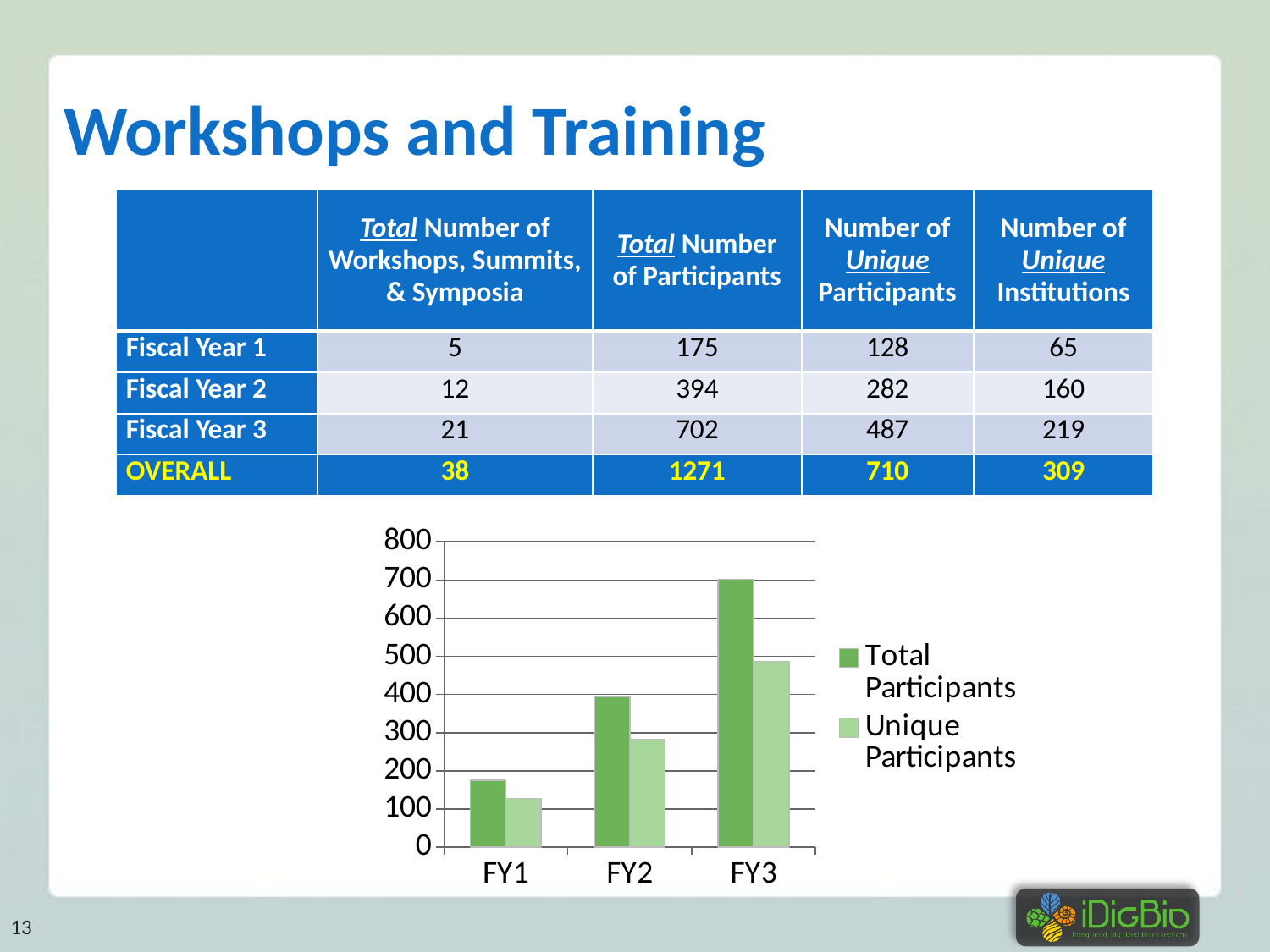
Which fiscal year has the lowest Unique Participants bar in the chart? FY1 In FY2, which is larger: Total Participants or Unique Participants? Total Participants Which fiscal year has the highest Total Participants bar in the chart? FY3 Which series is shown in the darker green colour in the chart? Total Participants How many series does the chart legend list? 2 Is the Total Participants value for FY3 greater or less than 600? greater What kind of chart is shown on the slide? bar chart Is the Total Participants value for FY2 greater or less than 300? greater Is the Unique Participants value for FY3 greater or less than 400? greater Do the Total Participants values rise or fall from FY1 to FY3? rise How many fiscal-year categories are shown on the chart's x axis? 3